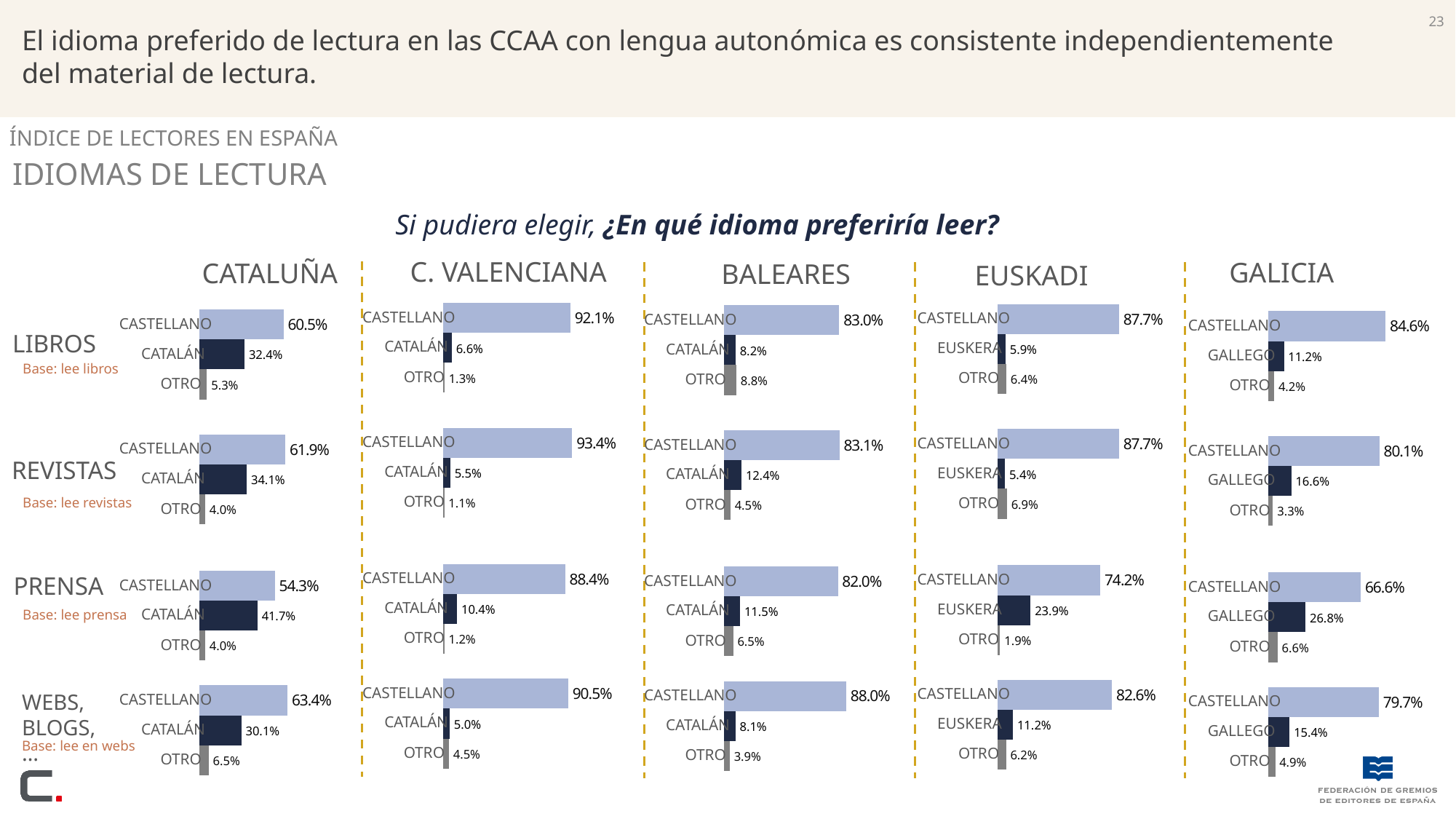
In the C. Valenciana / Revistas chart, what is the value for Catalán? 5.5% In the Cataluña / Prensa chart, which category has the highest value? Castellano In the Euskadi / Prensa chart, what is the value for Euskera? 23.9% Is the Castellano value in the Euskadi / Prensa chart larger or smaller than the Castellano value in the Baleares / Prensa chart? smaller How many bars are shown in the Euskadi / Libros chart? 3 In the Cataluña / Prensa chart, what is the difference between Castellano and Catalán? 12.6% How many regions (columns of charts) are shown on the slide? 5 In the Galicia / Revistas chart, what is the difference between Gallego and Otro? 13.3% In the Galicia / Webs, Blogs chart, what is the value for Gallego? 15.4% What type of chart is used for the Baleares / Webs, Blogs data? bar chart In the Cataluña / Libros chart, what is the value for Castellano? 60.5% In the Baleares / Libros chart, which category has the lowest value? Catalán